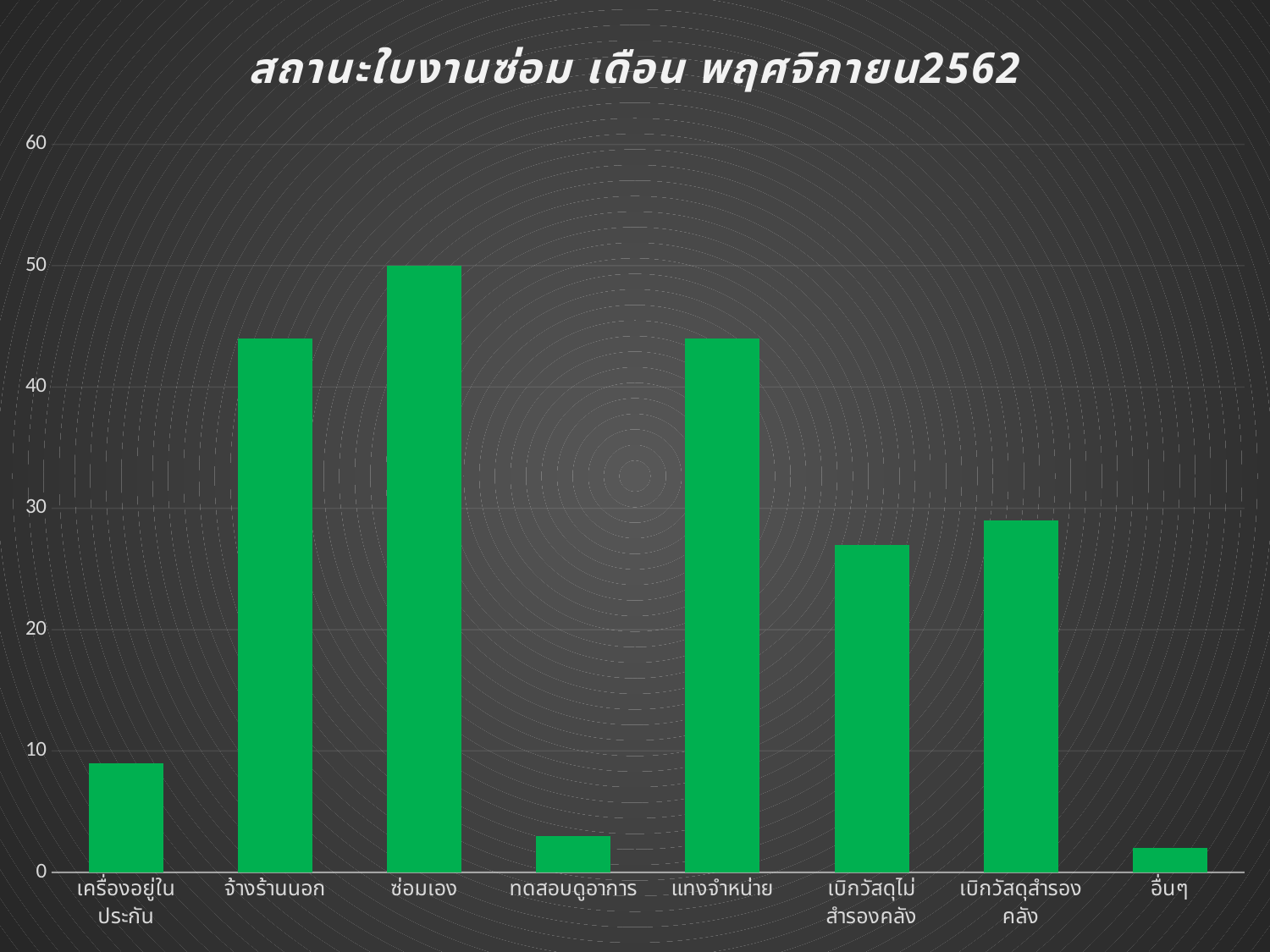
Which is larger, the value for ซ่อมเอง or the value for เบิกวัสดุไม่สำรองคลัง? ซ่อมเอง Is the value for ทดสอบดูอาการ greater or less than 10? less Which category has the highest value in the chart? ซ่อมเอง Is the value for เครื่องอยู่ในประกัน greater or less than 10? less What is the value for ซ่อมเอง? 50 How many categories are shown on the x axis of the chart? 8 Which is larger, the value for แทงจำหน่าย or the value for เครื่องอยู่ในประกัน? แทงจำหน่าย Is the value for จ้างร้านนอก greater or less than 40? greater What is the title of the chart? สถานะใบงานซ่อม เดือน พฤศจิกายน2562 What type of chart is shown on the slide? Bar chart Which category has the lowest value in the chart? อื่นๆ